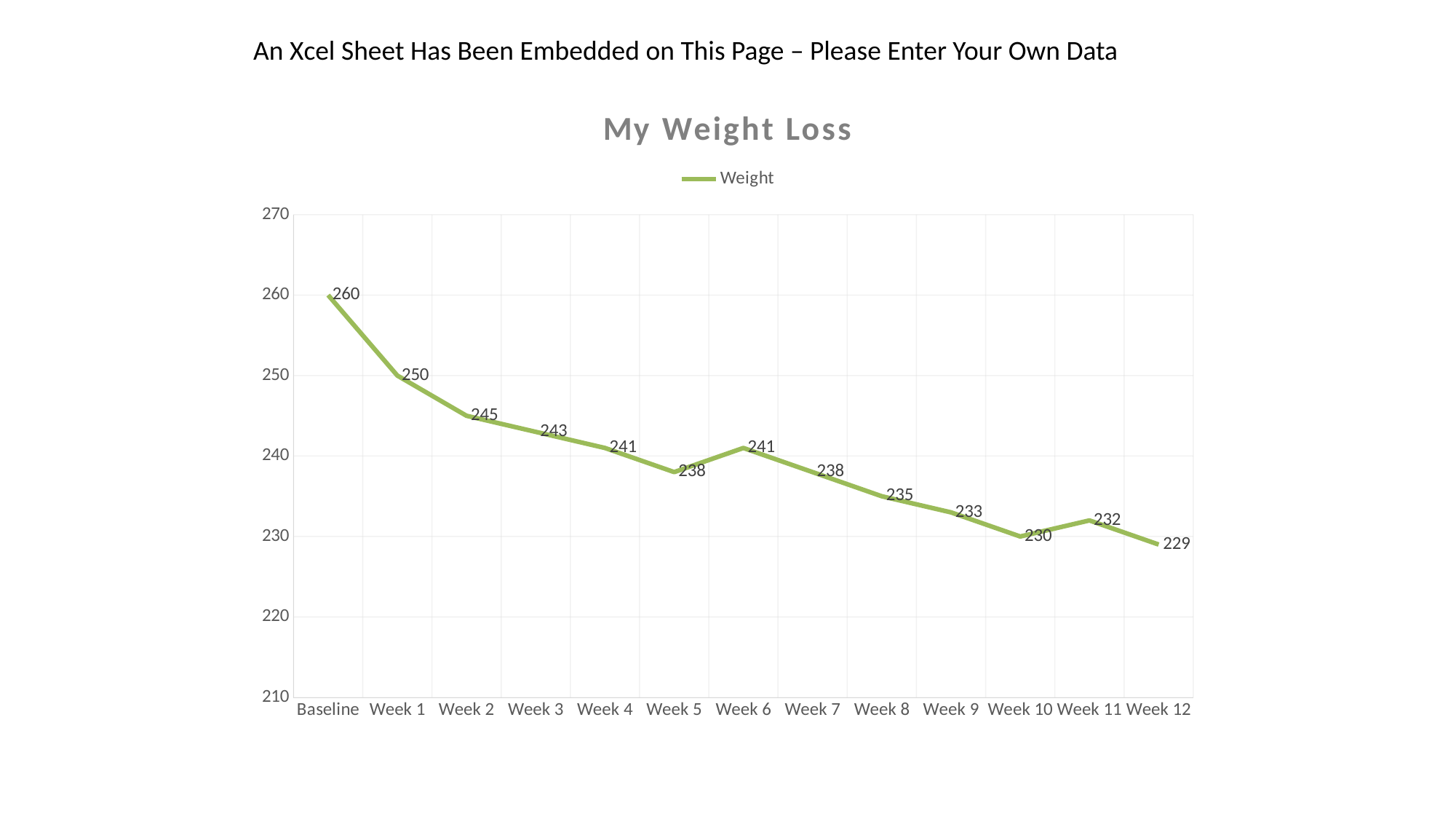
Which is larger, the weight at Week 10 or the weight at Week 11? Week 11 How many points are plotted on the chart? 13 Do the values generally rise or fall from Baseline to Week 12? Fall How many series does the legend list? 1 Which point has the lowest weight? Week 12 Which point has the highest weight? Baseline What is the weight at Baseline? 260 What kind of chart is shown? Line chart What is the difference between the weight at Week 1 and the weight at Week 2? 5 What is the difference between the weight at Baseline and the weight at Week 12? 31 What is the weight at Week 6? 241 What is the weight at Week 12? 229